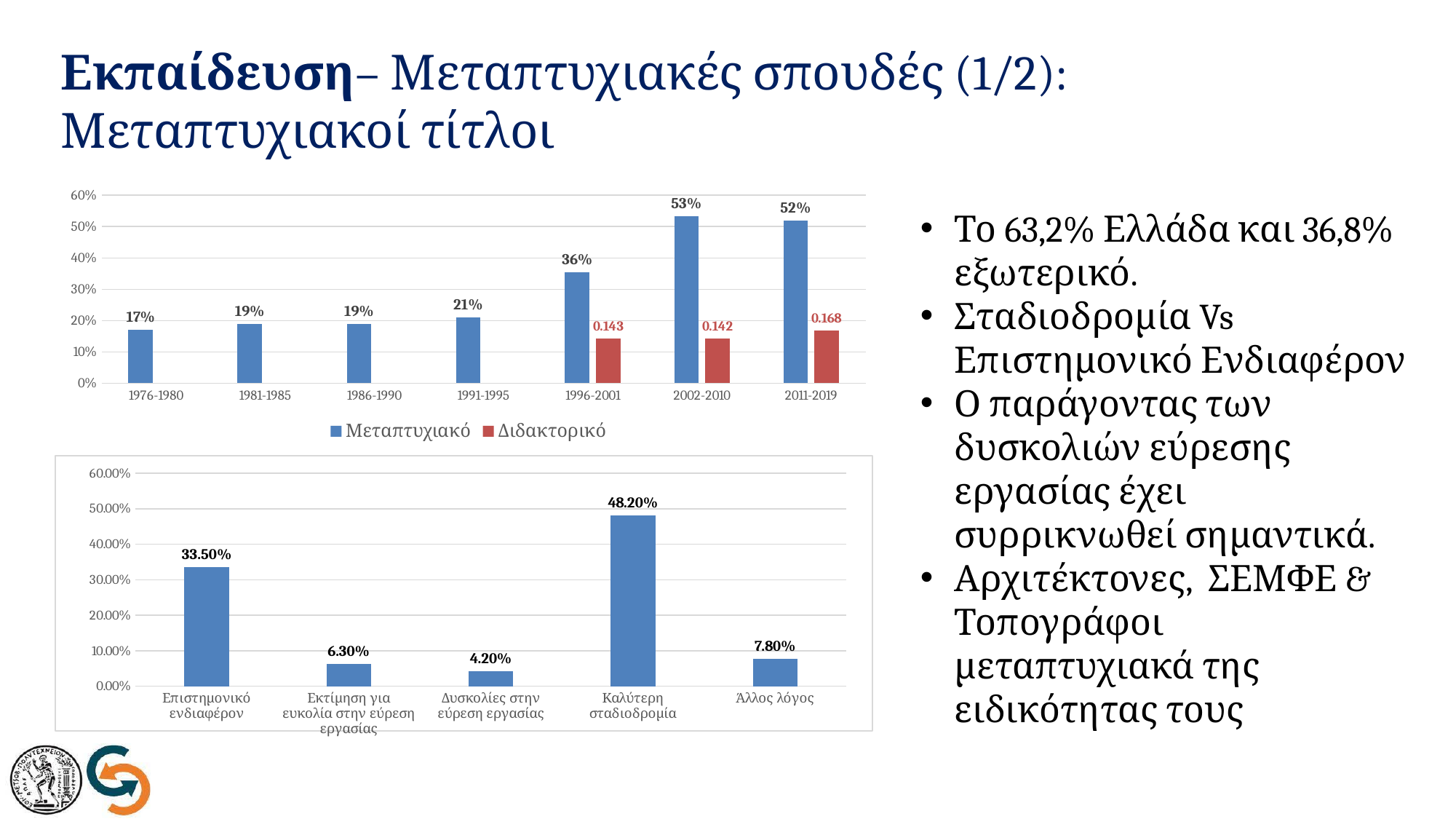
In the bottom chart, what is the value for Καλύτερη σταδιοδρομία? 48.20% In the bottom chart, which category has the lowest value? Δυσκολίες στην εύρεση εργασίας In the top chart, which period has the highest Μεταπτυχιακό value? 2002-2010 In the top chart, how many series does the legend list? 2 What kind of chart is the bottom chart? Bar chart In the top chart, which period has the lowest Μεταπτυχιακό value? 1976-1980 In the top chart, how many periods are shown on the x axis? 7 In the top chart, what is the Μεταπτυχιακό value for 2002-2010? 53% In the top chart, what is the Διδακτορικό value for 2011-2019? 0.168 In the top chart, is the Μεταπτυχιακό value for 1996-2001 greater or less than 30%? greater In the top chart, what is the difference between the Μεταπτυχιακό values for 1996-2001 and 1991-1995? 15% In the bottom chart, which is larger: Επιστημονικό ενδιαφέρον or Καλύτερη σταδιοδρομία? Καλύτερη σταδιοδρομία